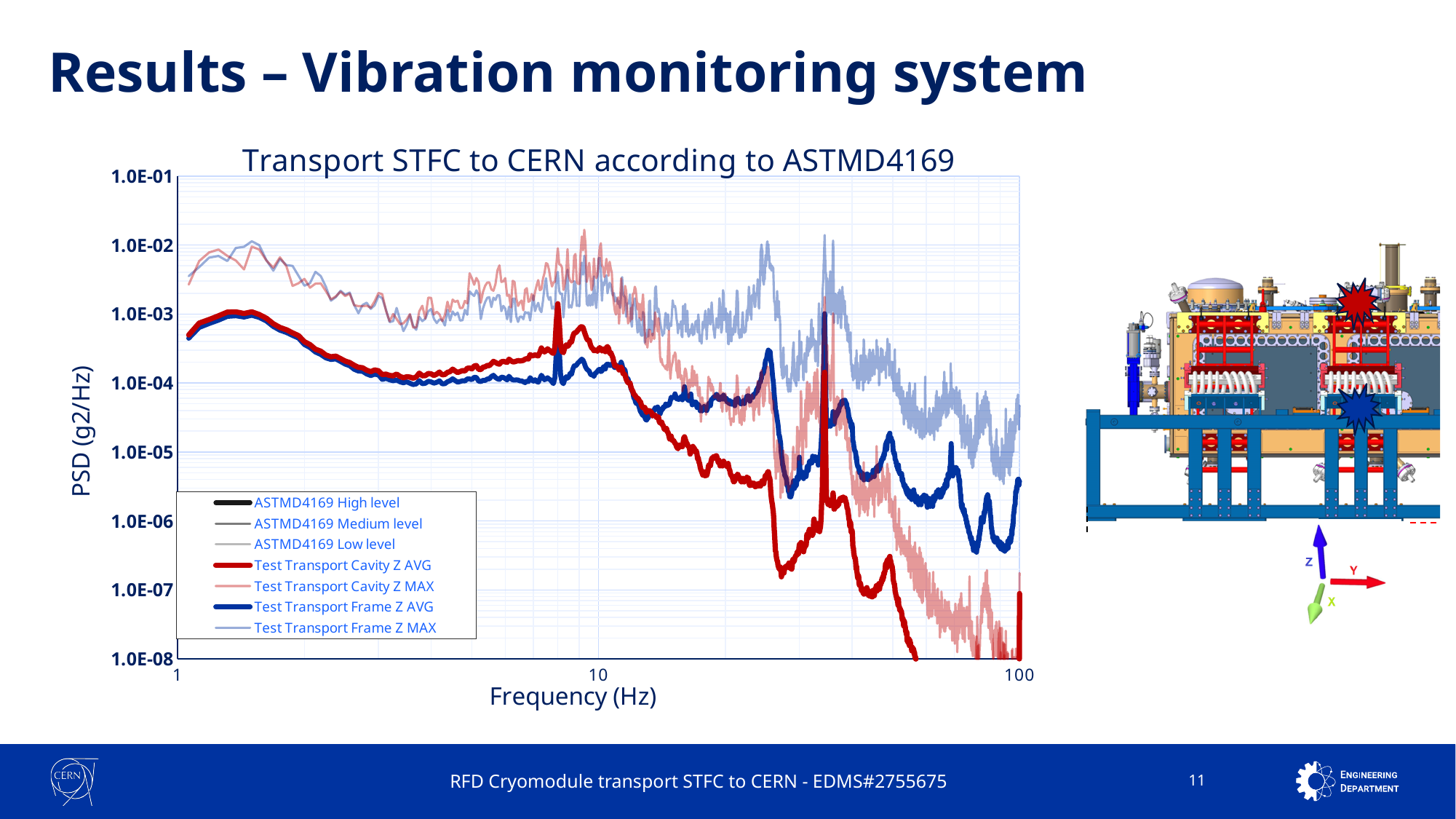
Is the value of Test Transport Cavity Z AVG at 100 Hz greater or less than 1.0E-05? less At 100 Hz, which is higher: Test Transport Frame Z AVG or Test Transport Cavity Z AVG? Test Transport Frame Z AVG Is the value of Test Transport Frame Z MAX at 100 Hz greater or less than 1.0E-06? greater What colour is the Test Transport Frame Z AVG line in the chart? Blue Is the value of Test Transport Frame Z MAX at 1 Hz greater or less than 1.0E-03? greater At 10 Hz, which is higher: Test Transport Cavity Z MAX or Test Transport Cavity Z AVG? Test Transport Cavity Z MAX Which series reaches the lowest PSD value on the chart? Test Transport Cavity Z AVG How many series does the chart legend list? 7 What is the title of the chart? Transport STFC to CERN according to ASTMD4169 Does the Test Transport Cavity Z AVG line generally rise or fall between 10 Hz and 100 Hz? Fall What kind of chart is shown on the slide? Line chart